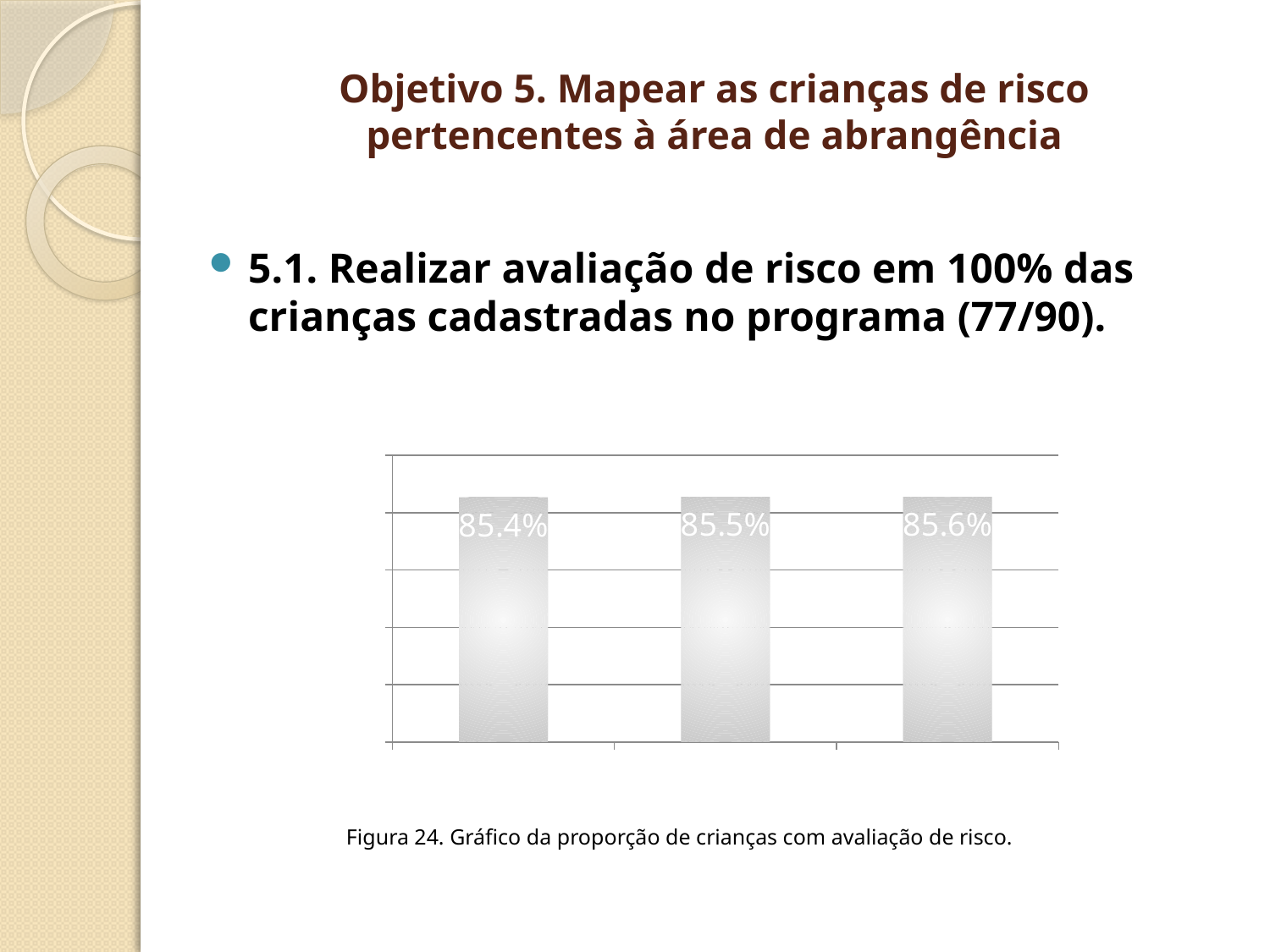
What is the value shown on the middle bar of the chart? 85.5% Which bar has the lowest value according to the data labels? The first (leftmost) bar, 85.4% What kind of chart is shown on the slide? Bar chart Which bar has the highest value according to the data labels? The third (rightmost) bar, 85.6% How many bars are plotted in the chart? 3 What is the value shown on the first (leftmost) bar of the chart? 85.4% Does the chart display a legend? No What is the difference between the value of the rightmost bar and the leftmost bar? 0.2% What is the figure caption below the chart? Figura 24. Gráfico da proporção de crianças com avaliação de risco. Which is larger, the value of the first bar or the value of the second bar? The second bar (85.5%) What is the value shown on the third (rightmost) bar of the chart? 85.6% Do the values rise or fall from left to right across the bars? Rise